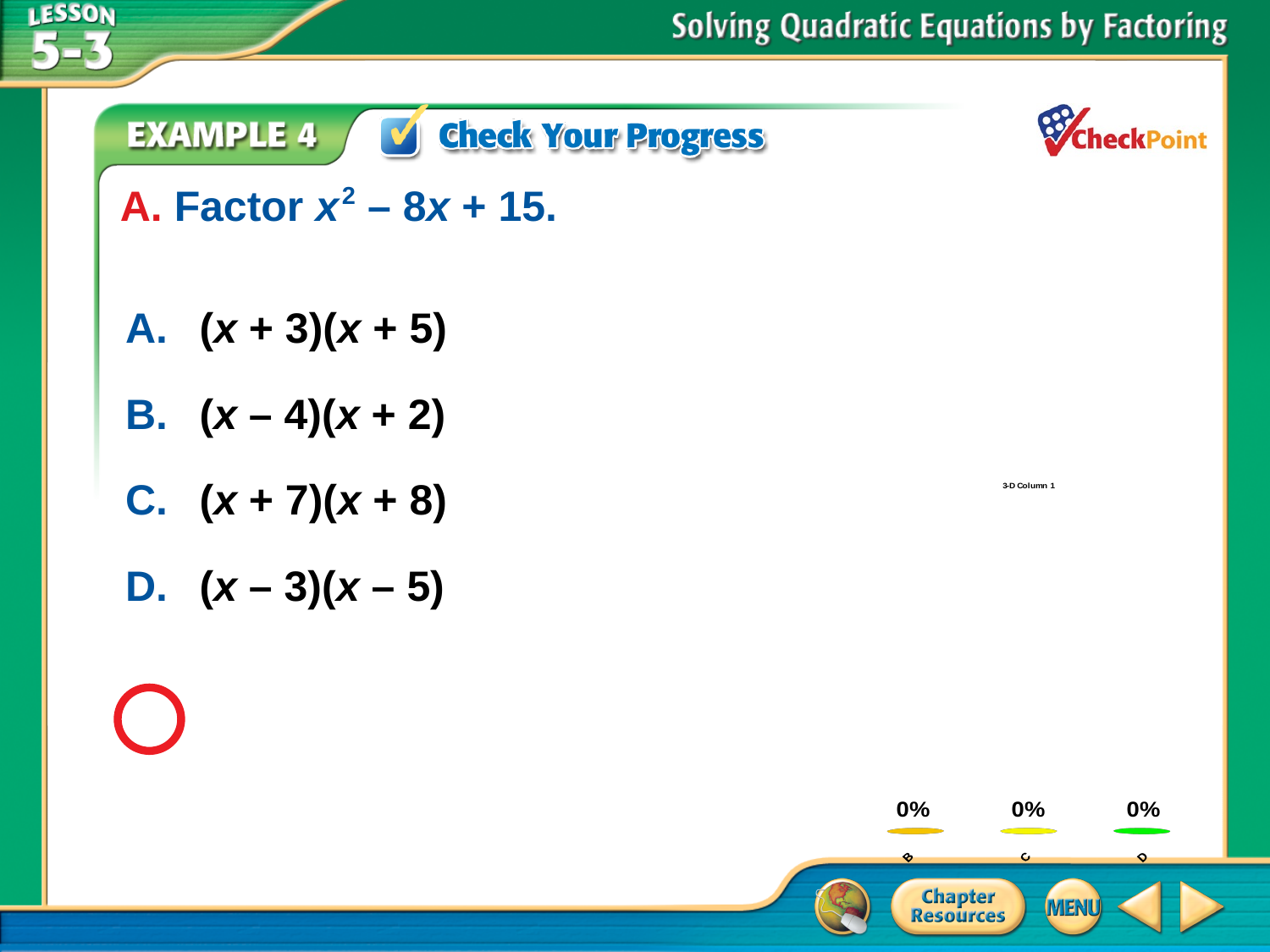
What is the value shown for category D in the chart? 0% What is the value shown for category B in the chart? 0% What kind of chart is shown on the slide? bar chart Is the value for category C in the chart greater or less than 50%? less What is the title of the chart on the slide? 3-D Column 1 What is the value shown for category C in the chart? 0%